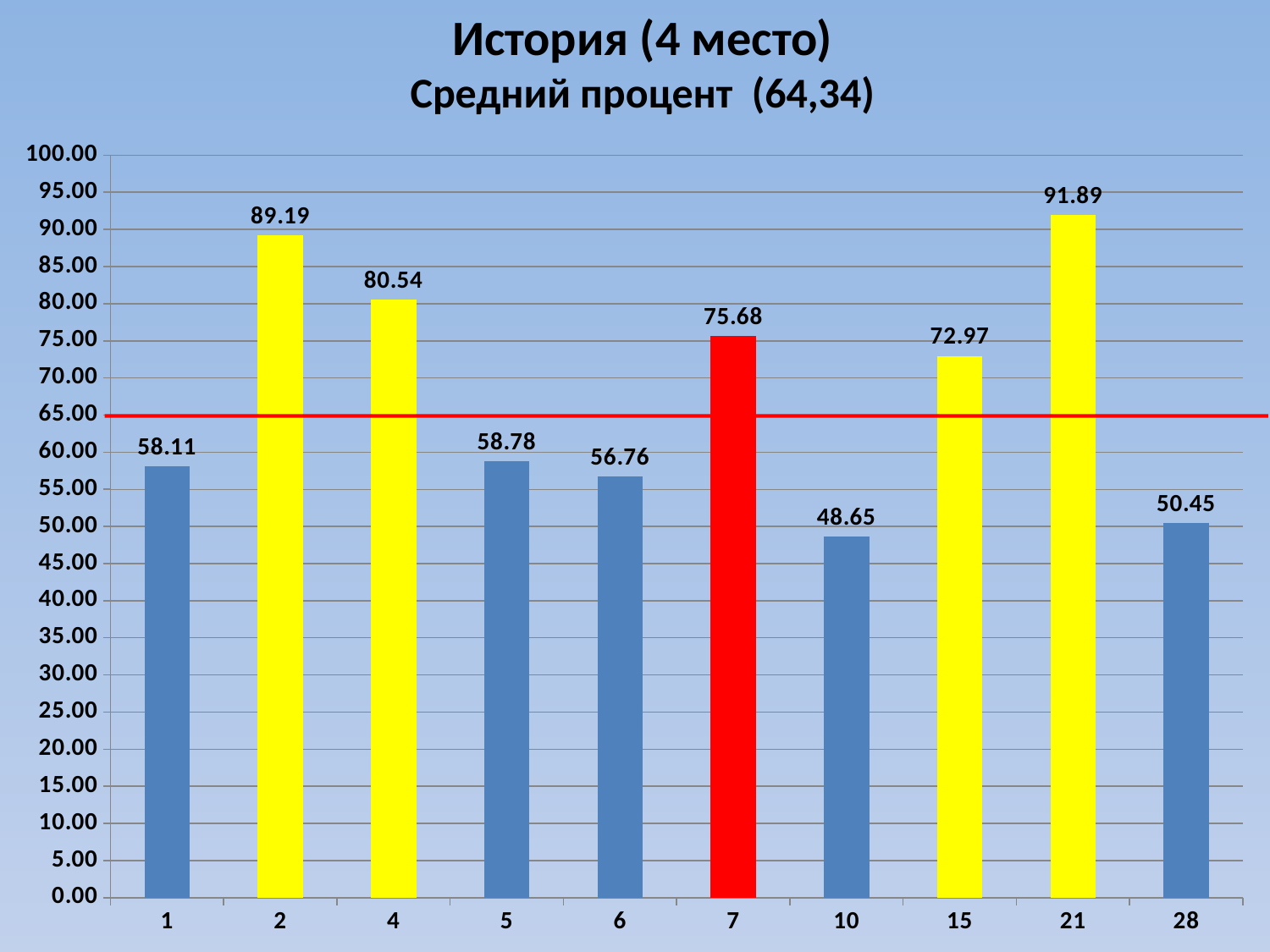
Is the value for category 6 greater or less than 60.00? less How many categories are shown on the x axis? 10 What is the value for category 7? 75.68 What colour is the bar for category 7? red Which is larger, the value for category 4 or the value for category 15? 4 What is the value for category 2? 89.19 What is the average percentage stated in the chart title? 64,34 What kind of chart is shown on the slide? bar chart What is the difference between the values for category 21 and category 2? 2.70 Which category has the lowest value? 10 Which category has the highest value? 21 What is the value for category 28? 50.45